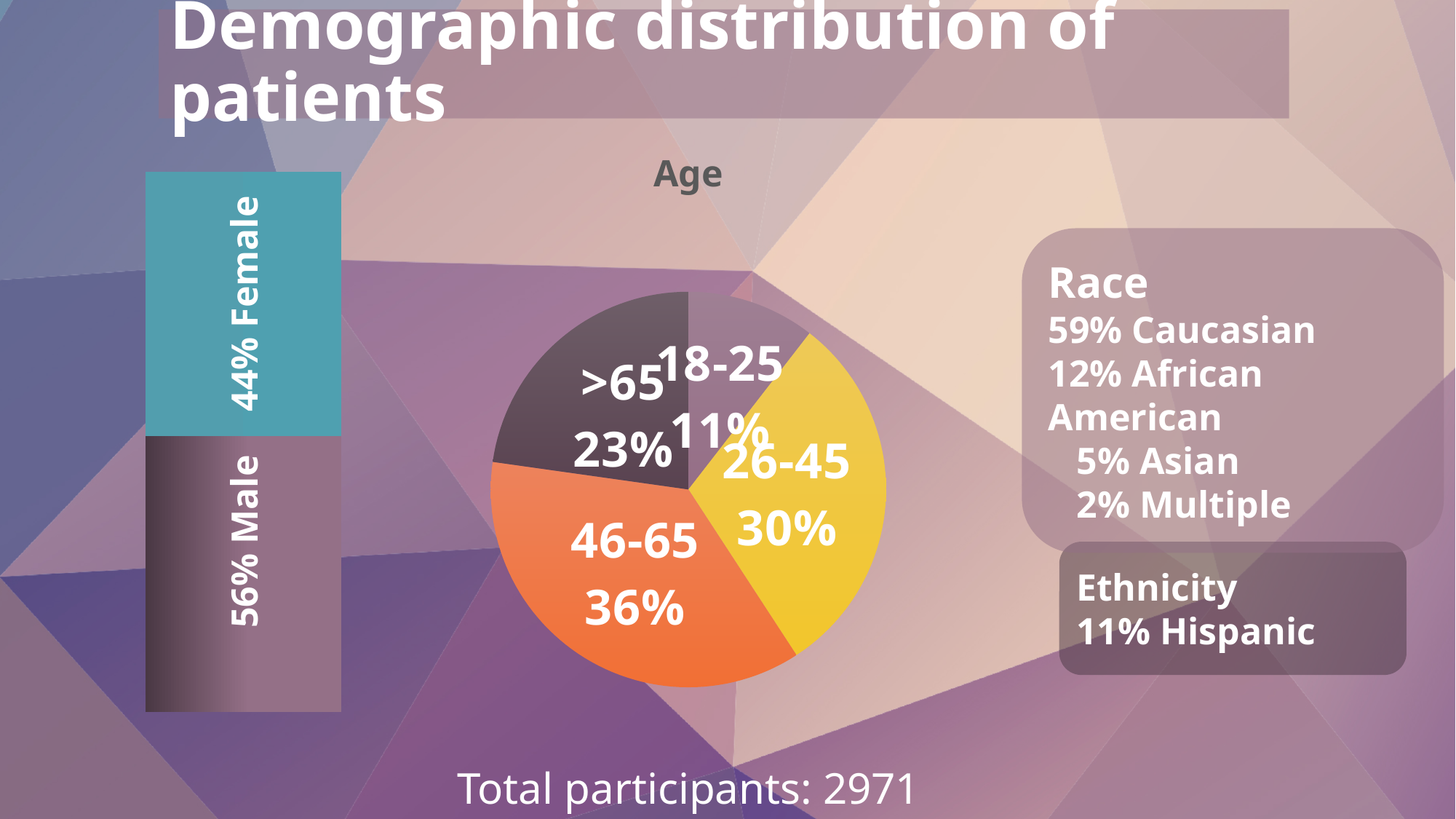
In the gender bar on the left of the slide, what percentage of patients are female? 44% In the Age pie chart, which age group has the largest share? 46-65 In the Age pie chart, what percentage of patients are aged 46-65? 36% In the Age pie chart, what is the difference in percentage points between the 46-65 group and the 18-25 group? 25 In the Age pie chart, what percentage of patients are aged 26-45? 30% How many age groups are shown in the Age pie chart? 4 In the gender bar on the left of the slide, which is larger: the male share or the female share? Male In the Age pie chart, which age group has the smallest share? 18-25 In the Age pie chart, which is larger: the share for 26-45 or the share for >65? 26-45 In the Age pie chart, what percentage of patients are aged 18-25? 11% What type of chart is used to show the Age distribution? pie chart In the Age pie chart, what percentage of patients are older than 65? 23%